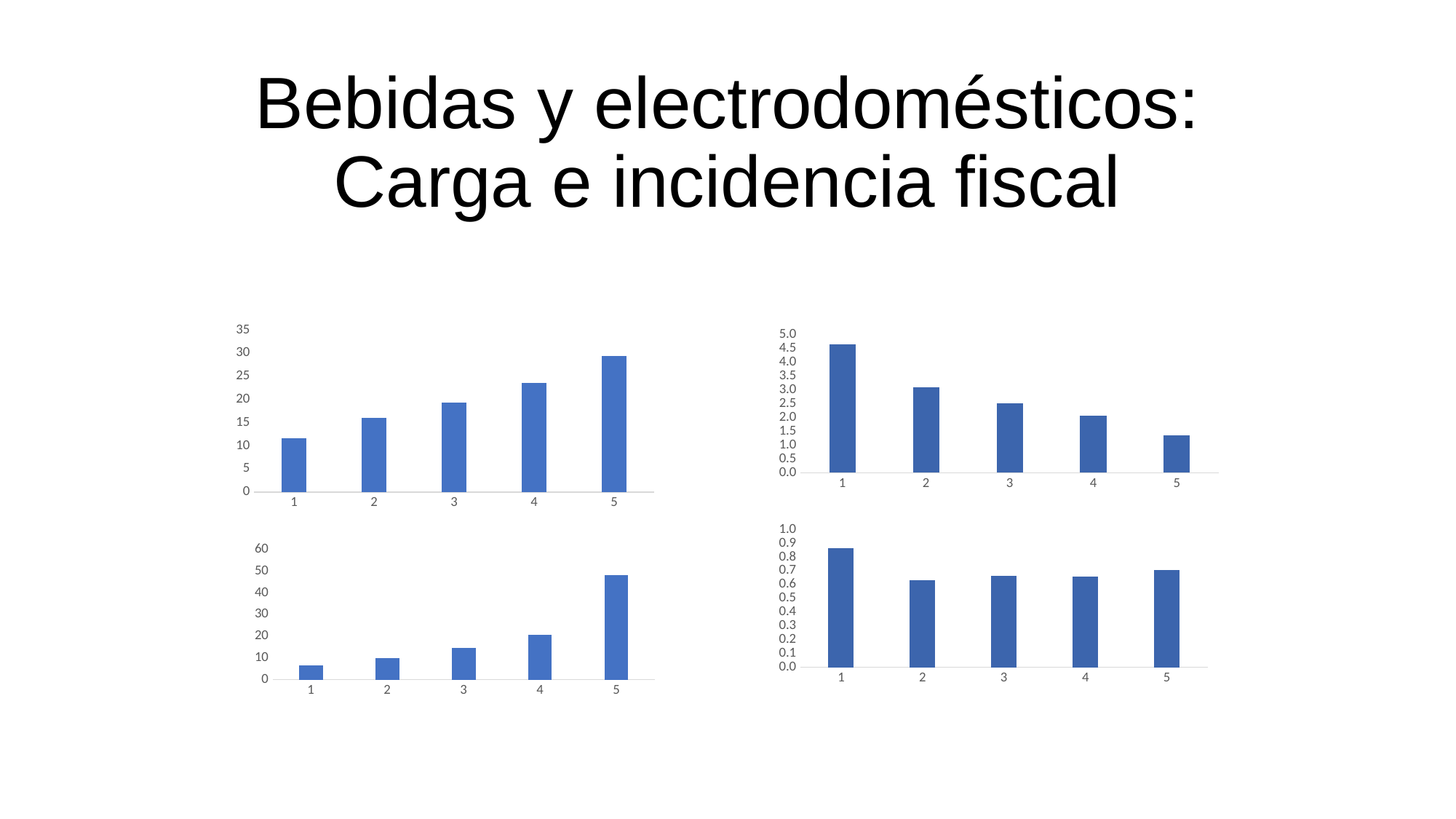
In the top-right chart, do the values rise or fall from category 1 to category 5? fall In the top-right chart, which category has the highest value? 1 In the top-left chart, which category has the highest value? 5 What kind of chart is the bottom-right chart? bar chart In the top-left chart, which category has the lowest value? 1 In the bottom-left chart, how many categories are shown on the x axis? 5 In the top-left chart, do the values rise or fall from category 1 to category 5? rise In the bottom-left chart, which category has the highest value? 5 In the bottom-right chart, is the value for category 1 greater or less than 0.8? greater In the top-left chart, is the value for category 5 greater or less than 25? greater In the bottom-left chart, is the value for category 5 greater or less than 40? greater In the top-right chart, which category has the lowest value? 5